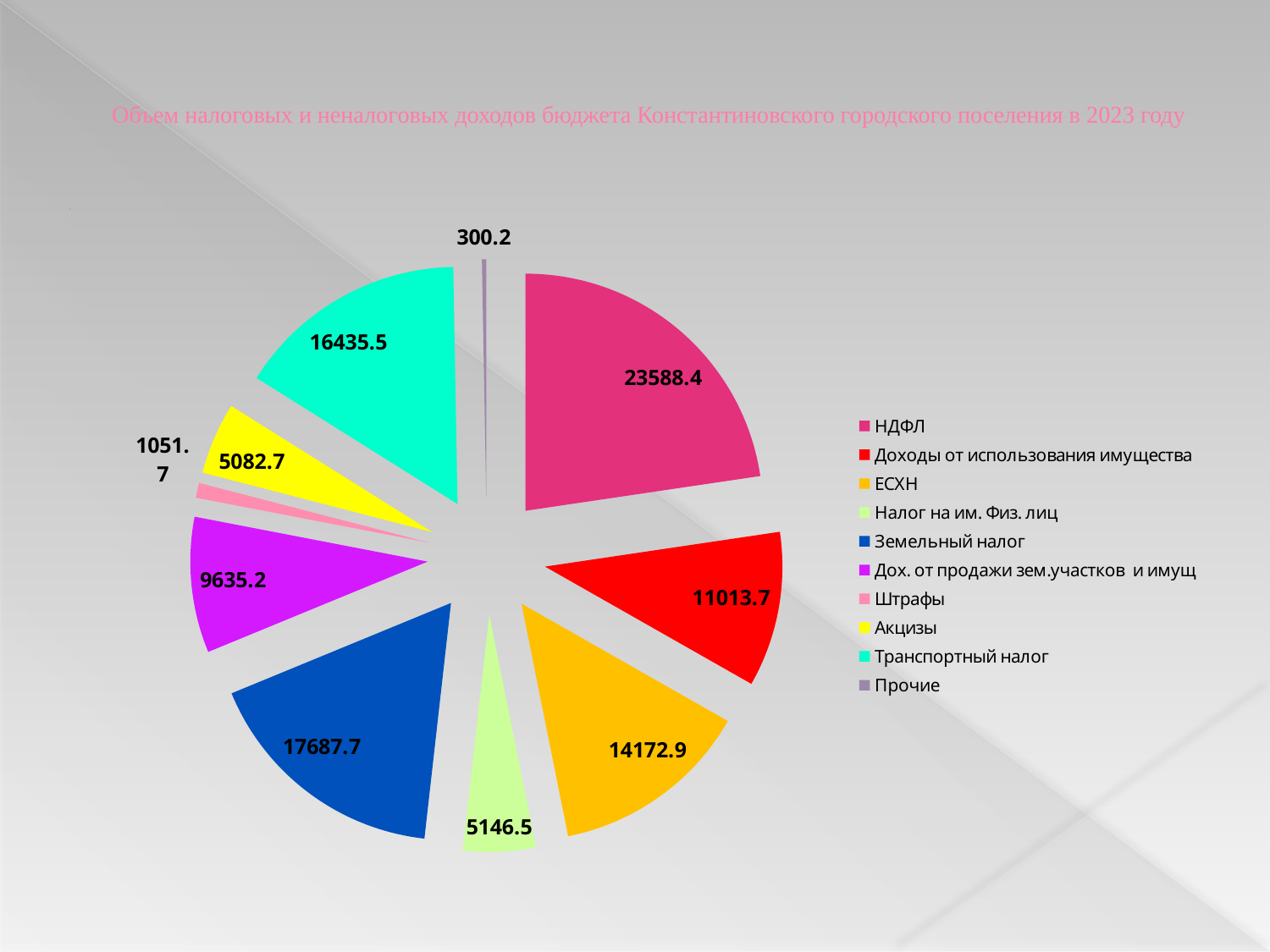
Which category has the largest slice? НДФЛ Which is larger, Земельный налог or Транспортный налог? Земельный налог What type of chart is shown on the slide? pie chart What is the value for НДФЛ? 23588.4 What colour is the slice for Акцизы? yellow Which category has the smallest slice? Прочие What is the value for Земельный налог? 17687.7 What is the value for Прочие? 300.2 How many categories does the pie chart have? 10 What is the difference between the values for НДФЛ and Земельный налог? 5900.7 What is the difference between the values for Транспортный налог and ЕСХН? 2262.6 What is the value for Штрафы? 1051.7